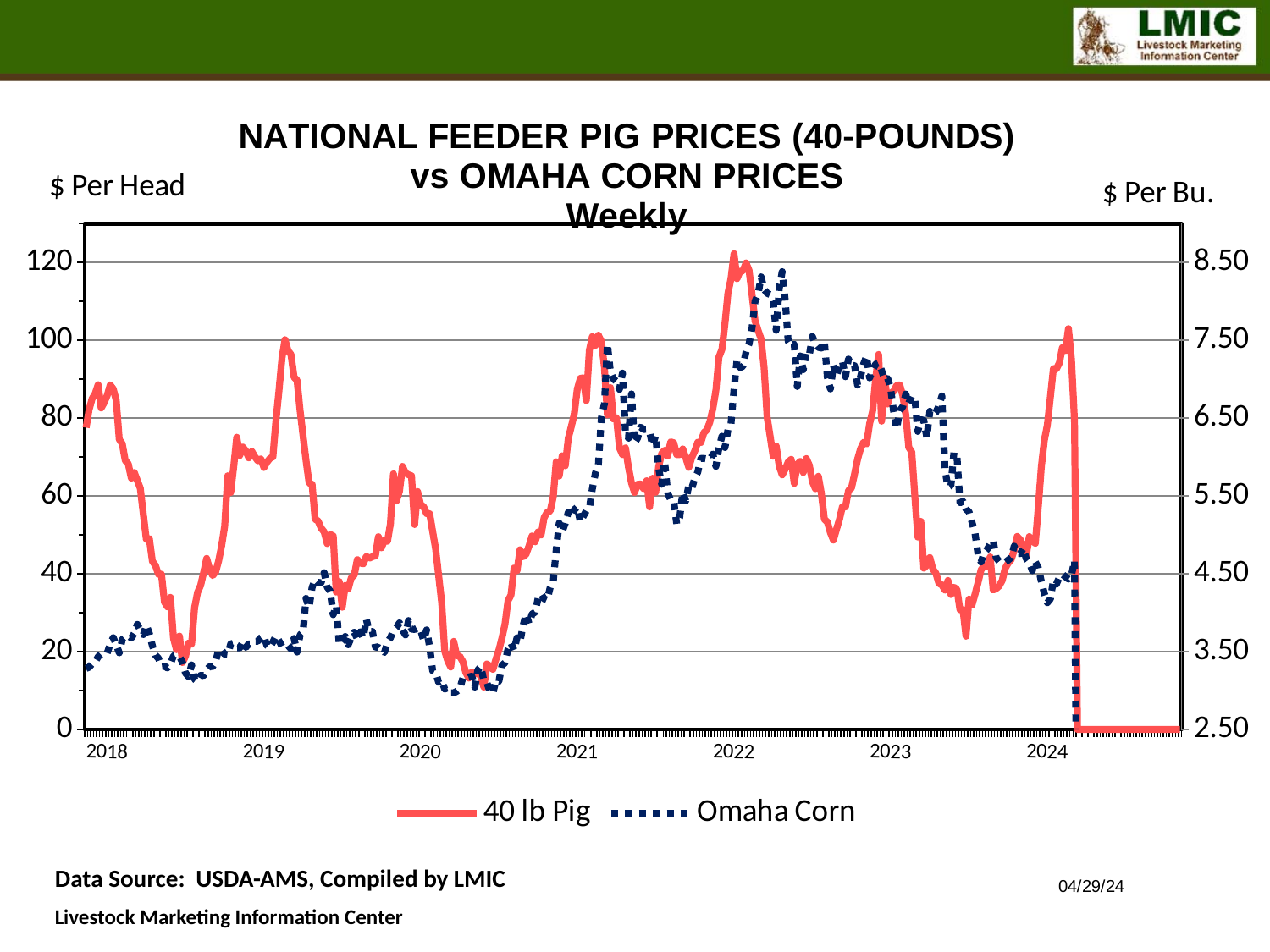
How many series does the legend list? 2 Is the 40 lb Pig price in mid-2020 greater or less than 20? less What are the two series named in the legend? 40 lb Pig and Omaha Corn Is the 40 lb Pig price at the start of 2018 greater or less than 60? greater What kind of chart is shown on the slide? Line chart How many year labels are shown on the x axis? 7 Is the peak 40 lb Pig price in early 2022 greater or less than 100? greater What is the unit label on the right-hand axis? $ Per Bu. In which year does the 40 lb Pig price reach its highest point? 2022 Does the Omaha Corn price rise or fall from 2020 to early 2022? rise